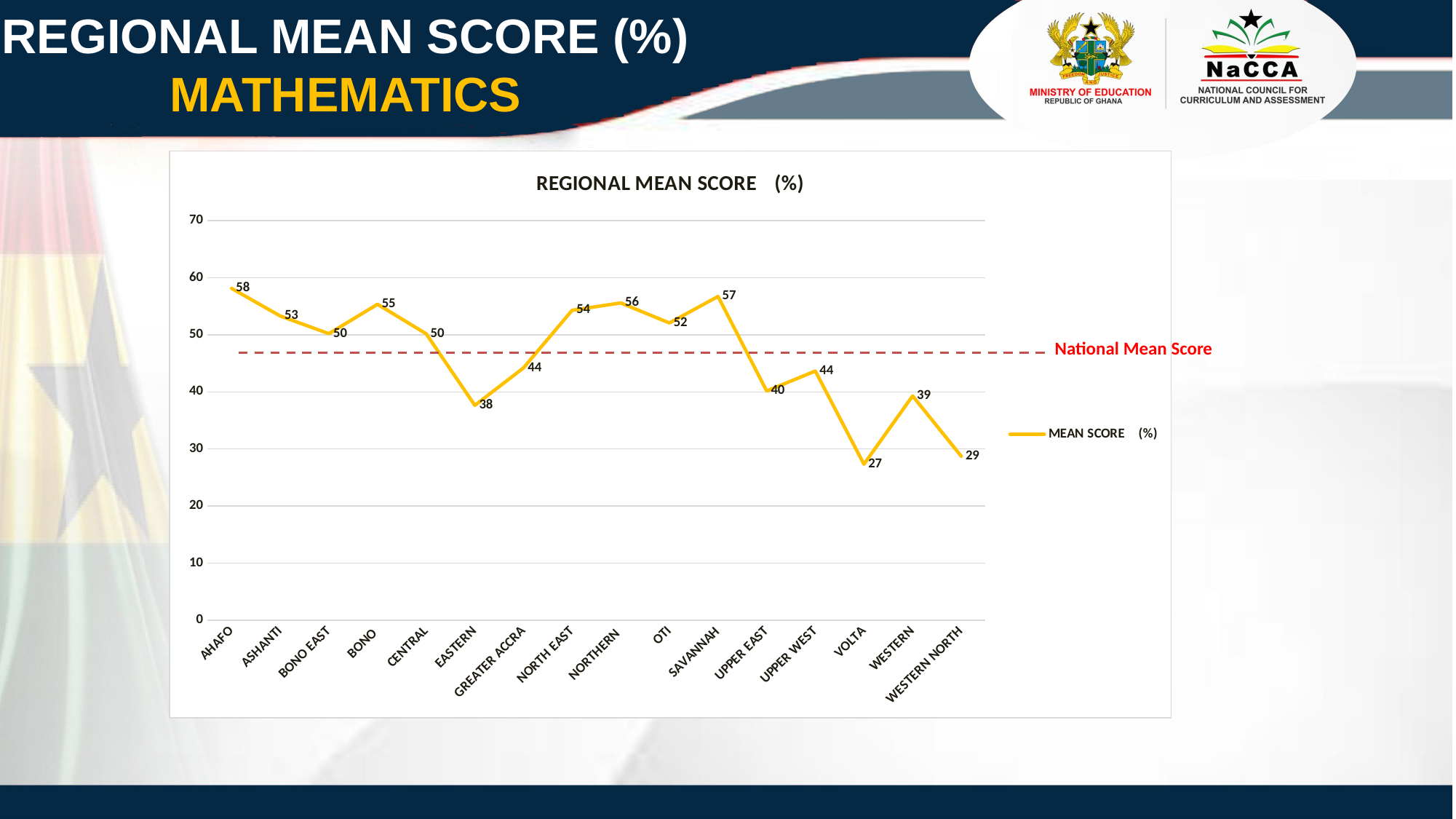
What kind of chart is shown on the slide? line chart Is the mean score for Greater Accra greater or less than 50? less What is the mean score for Western North region? 29 Which region has the highest mean score? AHAFO What is the mean score for Savannah region? 57 Which region has the lowest mean score? VOLTA What is the mean score for Eastern region? 38 What does the red dashed horizontal line on the chart represent? National Mean Score How many regions are plotted on the chart? 16 How many series does the legend list? 1 Which region has a higher mean score, Northern or Upper East? NORTHERN What is the difference between the mean scores of Ahafo and Volta? 31